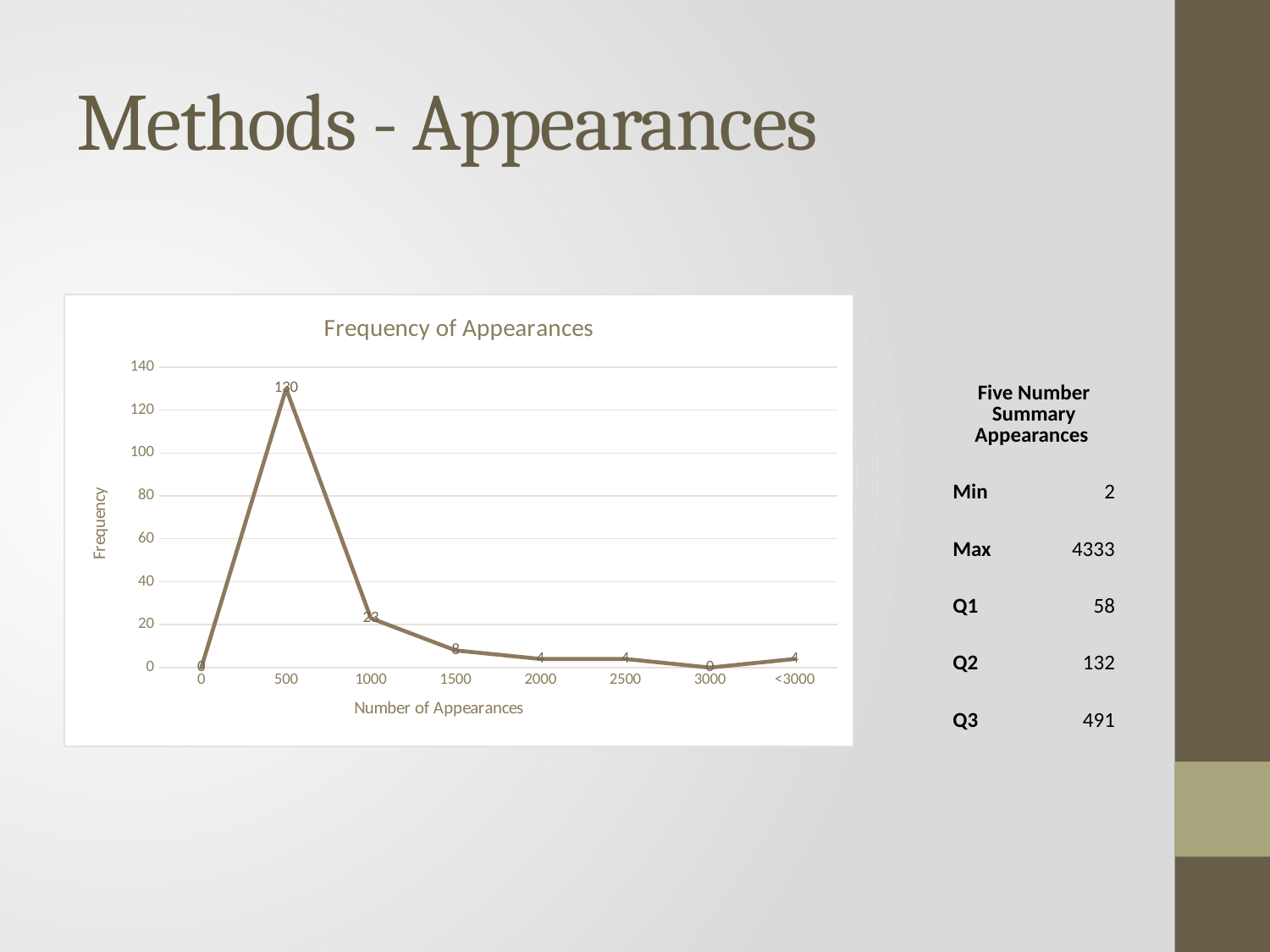
What type of chart is shown on the slide? line chart How many data points are plotted on the line? 8 What is the frequency value for the <3000 category? 4 What is the frequency value at 3000 appearances? 0 What is the frequency value at 1500 appearances? 8 What is the title of the chart? Frequency of Appearances Is the frequency at 500 appearances greater or less than 120? greater What is the difference between the frequency at 1500 and the frequency at 2000? 4 What is the label of the x axis of the chart? Number of Appearances Which x-axis category has the highest frequency? 500 What is the frequency value at 2000 appearances? 4 Is the frequency at 1000 appearances greater or less than 40? less